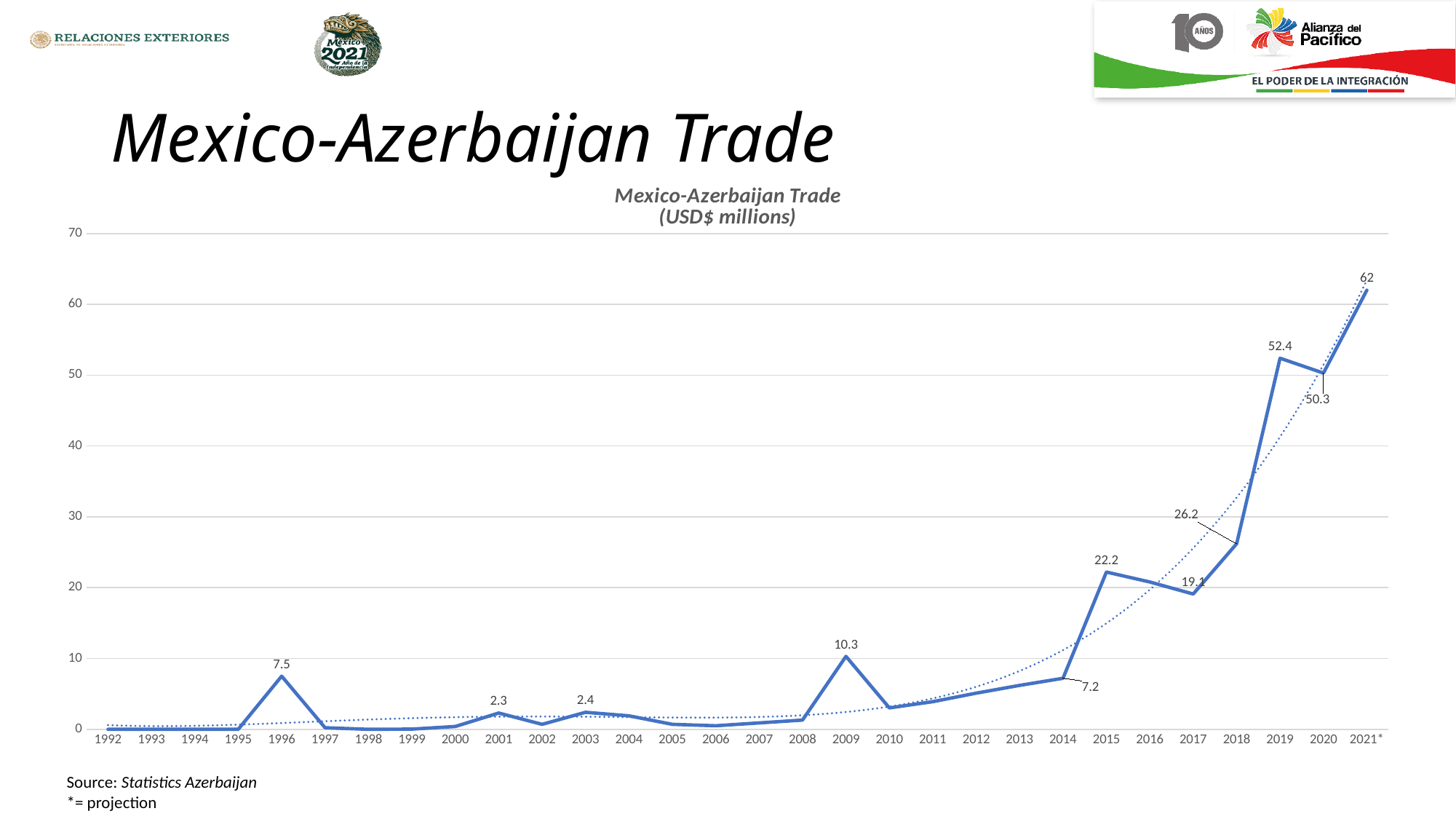
What is the difference between the values for 2019 and 2020? 2.1 Which year has the highest value on the chart? 2021* Is the value for 2010 greater or less than 10? less What is the value for 2021*? 62 Which is larger, the value for 2015 or the value for 2017? 2015 What is the value for 1996? 7.5 What is the difference between the values for 2018 and 2017? 7.1 What kind of chart is shown on the slide? line chart How many years are shown on the x axis? 30 What is the value for 2019? 52.4 What unit is given in the chart title? USD$ millions What is the value for 2009? 10.3